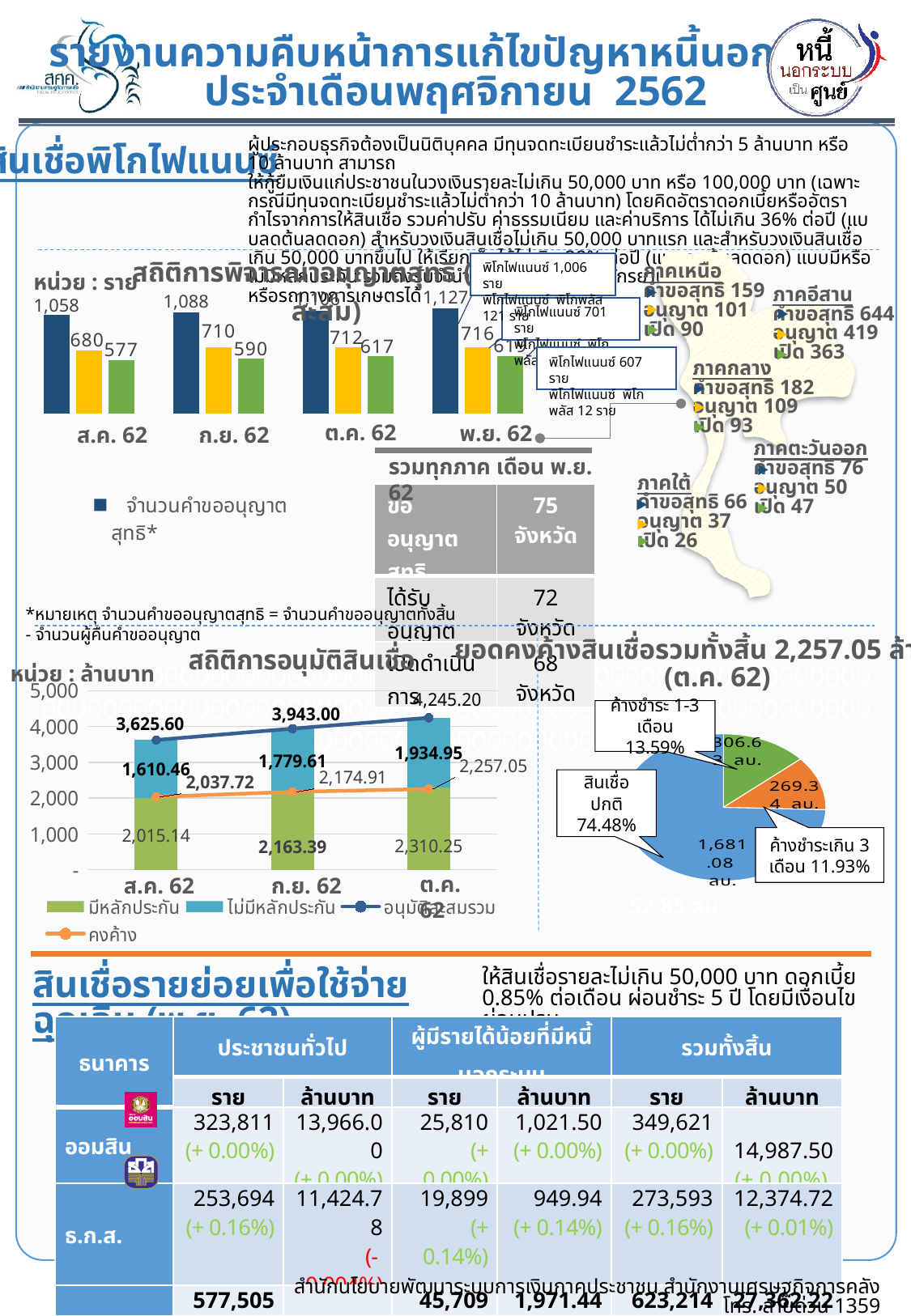
In the top bar chart (สถิติการพิจารณาอนุญาต), what is the value of the yellow bar for ก.ย. 62? 710 In the top bar chart (สถิติการพิจารณาอนุญาต), what is the value of the dark blue bar (จำนวนคำขออนุญาตสุทธิ) for ส.ค. 62? 1,058 In the top bar chart (สถิติการพิจารณาอนุญาต), which is larger for ก.ย. 62: the yellow bar or the green bar? the yellow bar (710) In the pie chart (ยอดคงค้างสินเชื่อรวมทั้งสิ้น 2,257.05 ล้านบาท), what share does สินเชื่อปกติ have? 74.48% In the pie chart (ยอดคงค้างสินเชื่อรวมทั้งสิ้น 2,257.05 ล้านบาท), which slice is the smallest? ค้างชำระเกิน 3 เดือน (11.93%) In the top bar chart (สถิติการพิจารณาอนุญาต), what is the difference between the dark blue bar and the green bar for ส.ค. 62? 481 In the bottom-left chart (สถิติการอนุมัติสินเชื่อ), how many series does the legend list? 4 In the bottom-left chart (สถิติการอนุมัติสินเชื่อ), what is the value of มีหลักประกัน for ก.ย. 62? 2,163.39 In the top bar chart (สถิติการพิจารณาอนุญาต), how many months are shown on the x axis? 4 In the bottom-left chart (สถิติการอนุมัติสินเชื่อ), what is the difference between คงค้าง for ต.ค. 62 and ส.ค. 62? 219.33 In the bottom-left chart (สถิติการอนุมัติสินเชื่อ), does the อนุมัติสะสมรวม line rise or fall from ส.ค. 62 to ต.ค. 62? rise In the bottom-left chart (สถิติการอนุมัติสินเชื่อ), what is the value of อนุมัติสะสมรวม for ต.ค. 62? 4,245.20